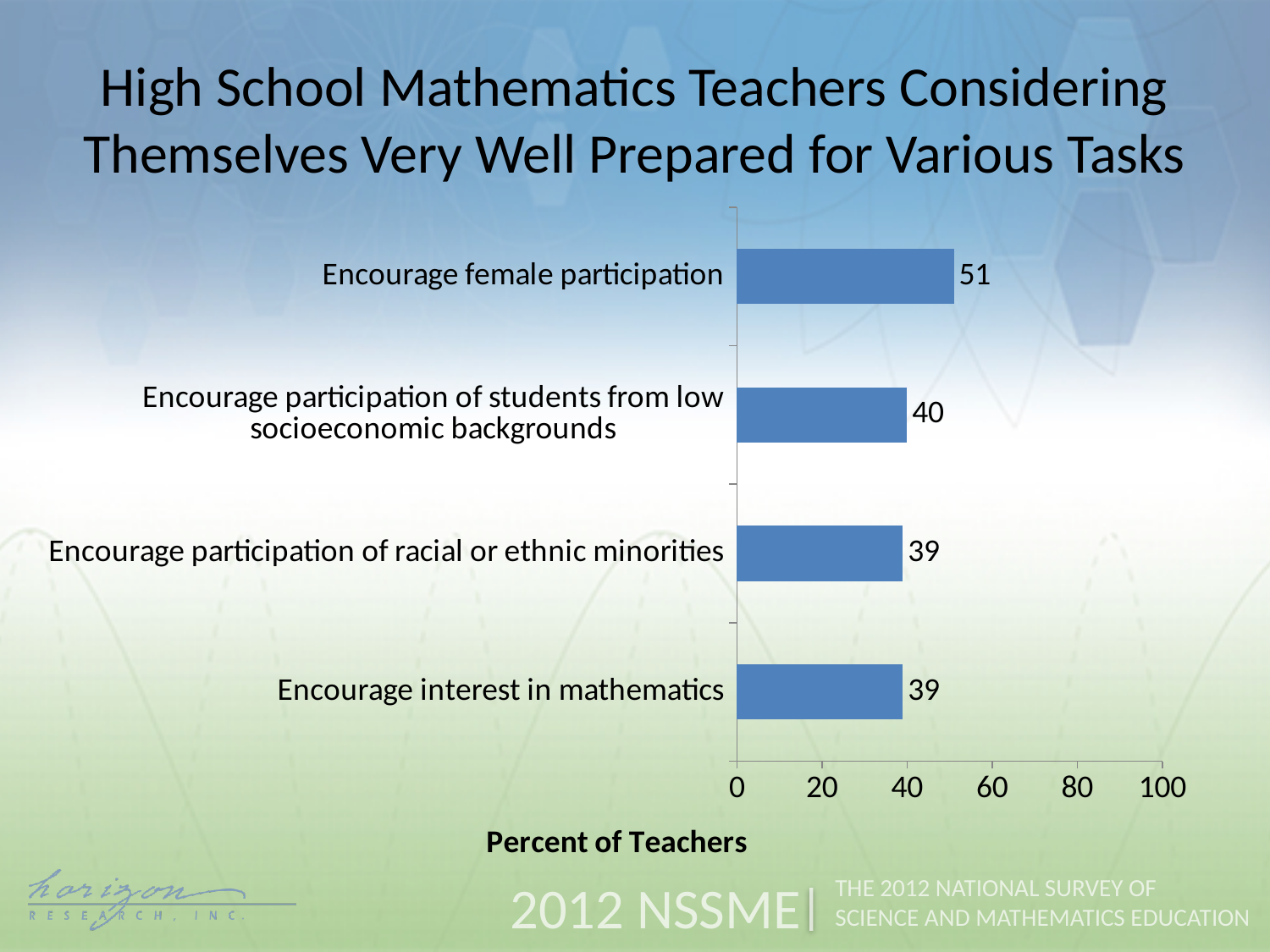
What is the difference between the values for 'Encourage female participation' and 'Encourage participation of racial or ethnic minorities'? 12 Is the value for 'Encourage female participation' greater or less than 60? less What is the maximum value shown on the horizontal axis? 100 What is the difference between the values for 'Encourage participation of students from low socioeconomic backgrounds' and 'Encourage interest in mathematics'? 1 Which task has the highest percent of teachers considering themselves very well prepared? Encourage female participation Which is larger: the value for 'Encourage female participation' or the value for 'Encourage participation of students from low socioeconomic backgrounds'? Encourage female participation What percent of teachers consider themselves very well prepared to encourage female participation? 51 What is the value for 'Encourage interest in mathematics'? 39 What kind of chart is shown on the slide? bar chart What is the label of the horizontal axis? Percent of Teachers What is the value for 'Encourage participation of students from low socioeconomic backgrounds'? 40 How many tasks (categories) are shown in the chart? 4